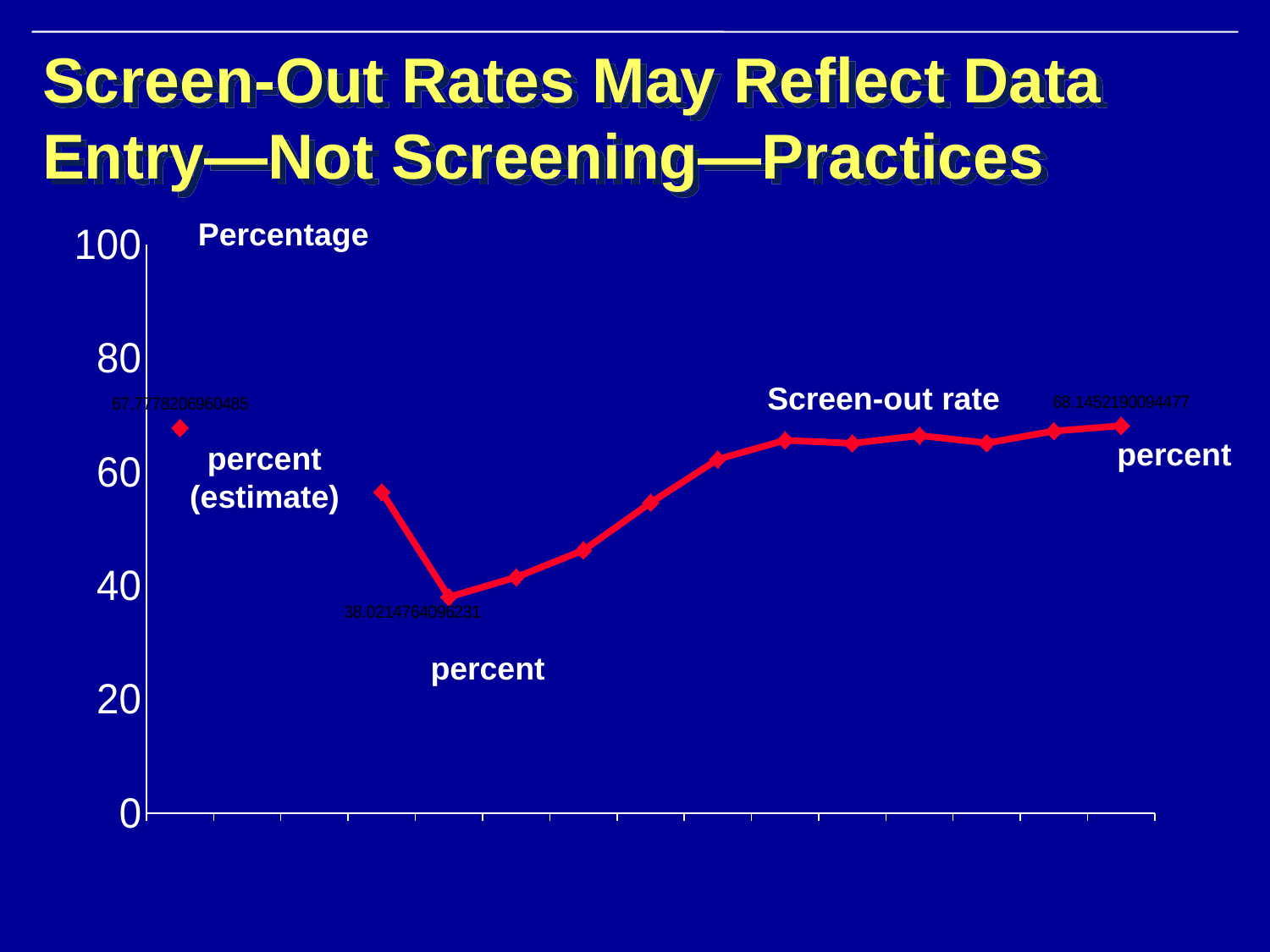
From the lowest point of the line to the last point on the right, do the values generally rise or fall? rise Is the last point of the screen-out rate line greater or less than 60? greater Is the lowest point of the screen-out rate line greater or less than 40? less What is the value printed at the lowest point of the screen-out rate line? 38.0214764096231 What is the difference between the isolated estimate point (67.7778206960485) and the lowest point (38.0214764096231)? 29.7563442864254 What is the value printed at the last point on the right of the screen-out rate line? 68.1452190094477 What is the value printed at the isolated first (estimate) point on the left of the chart? 67.7778206960485 What is the name of the plotted series labelled on the chart? Screen-out rate What kind of chart is shown on the slide? line chart What is the title of the vertical axis? Percentage Is the first point of the connected screen-out rate line greater or less than 40? greater Which is larger, the isolated estimate point on the left or the lowest point of the line? the isolated estimate point